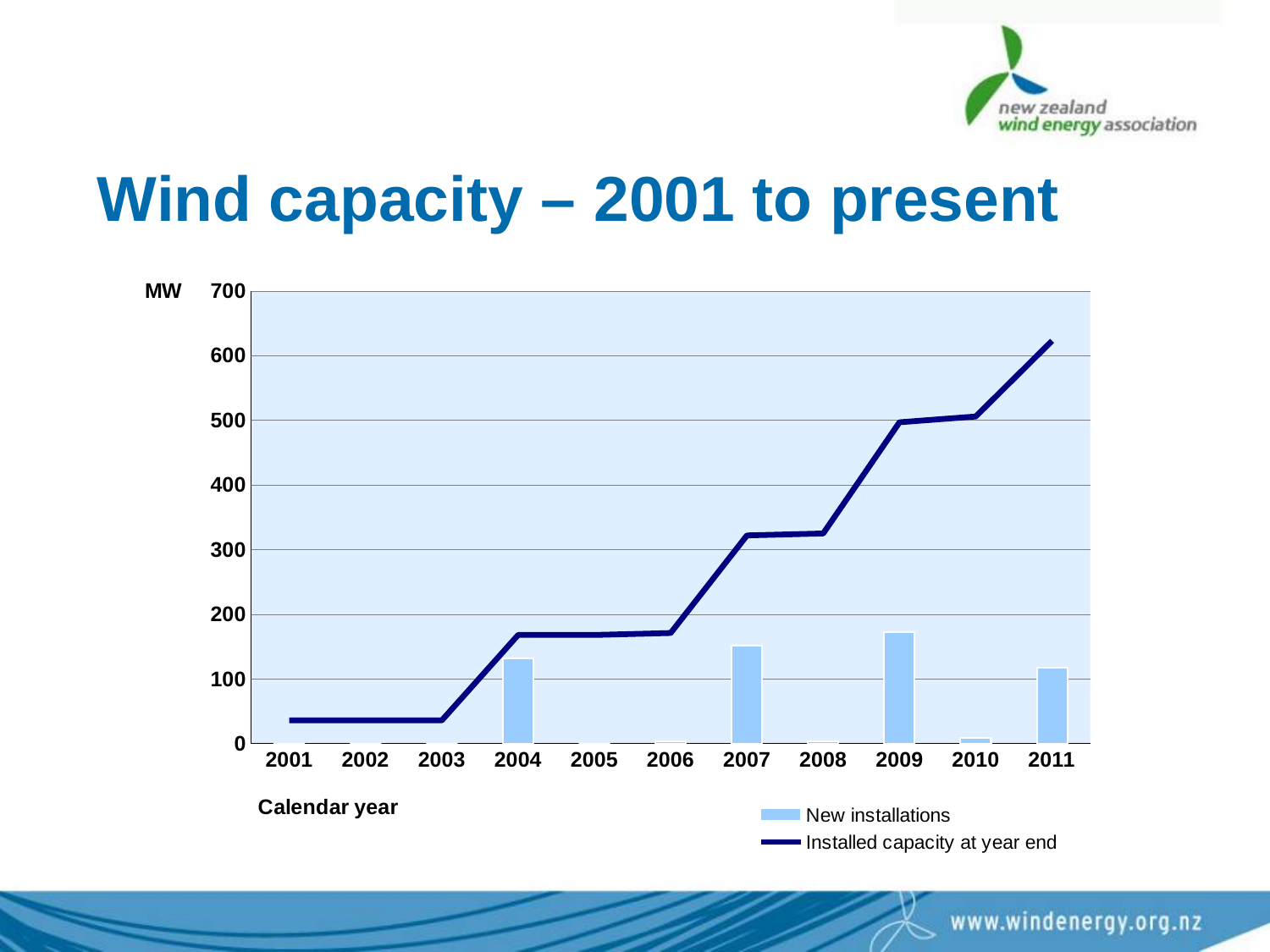
Are the new installations in 2010 greater or less than 100? less What is the title of the chart? Wind capacity – 2001 to present In which year are new installations highest? 2009 Is the installed capacity at year end for 2011 greater or less than 600? greater Which year had more new installations, 2009 or 2011? 2009 How many calendar years are shown on the x axis? 11 What are the two series named in the legend? New installations; Installed capacity at year end What kind of chart is shown on the slide? A combined bar and line chart How many series does the legend list? 2 In which year is the installed capacity at year end highest? 2011 Does the installed capacity at year end rise or fall from 2001 to 2011? Rise Is the installed capacity at year end for 2004 greater or less than 200? less